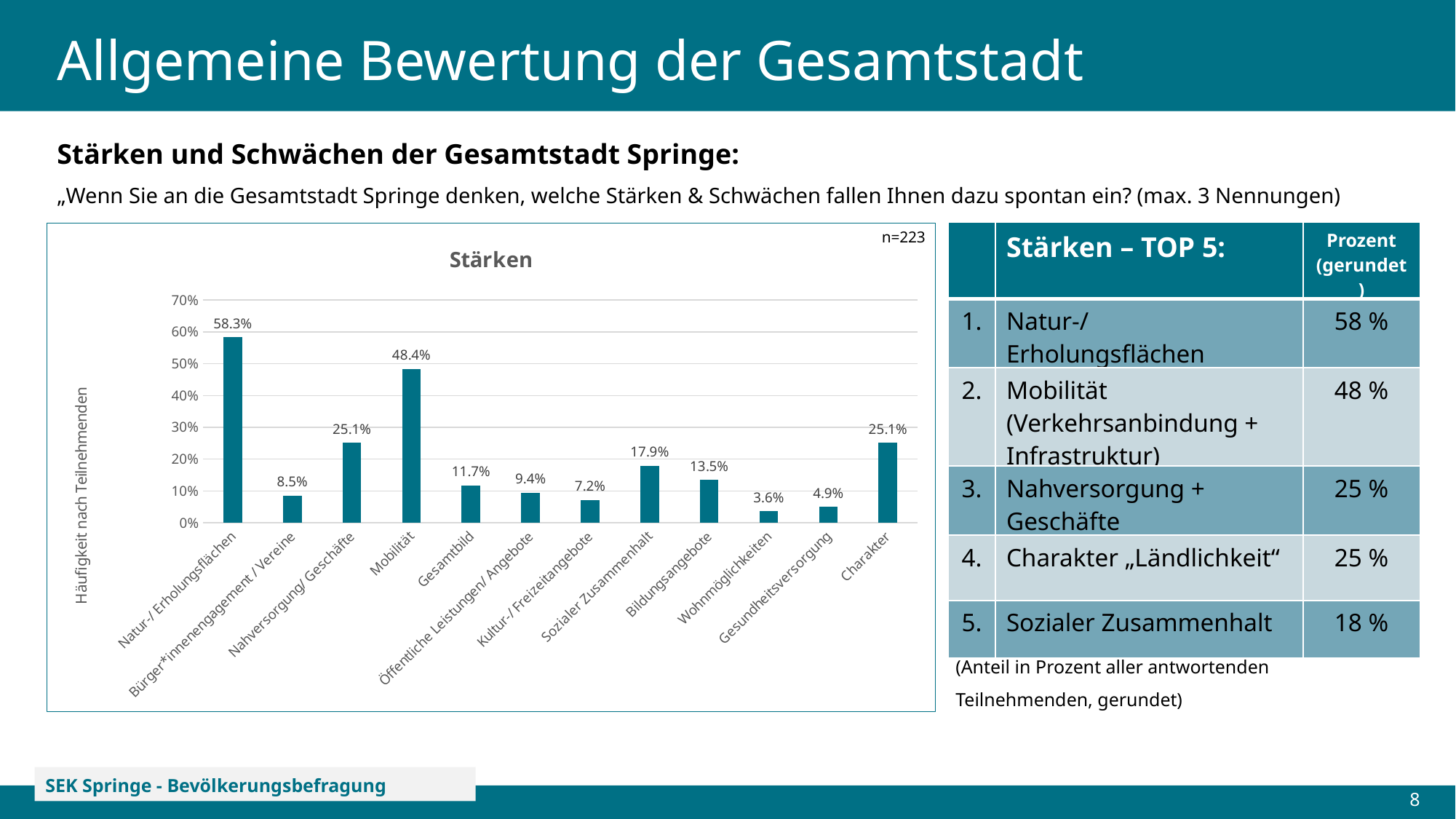
What is the sample size (n) shown on the Stärken chart? n=223 How many categories are shown in the Stärken chart? 12 What kind of chart is the Stärken chart? bar chart Which is larger in the Stärken chart: Bildungsangebote or Gesamtbild? Bildungsangebote Is the value for Sozialer Zusammenhalt in the Stärken chart greater or less than 20%? less What is the value for Natur-/ Erholungsflächen in the Stärken chart? 58.3% What is the value for Sozialer Zusammenhalt in the Stärken chart? 17.9% What is the value for Wohnmöglichkeiten in the Stärken chart? 3.6% Which category has the lowest value in the Stärken chart? Wohnmöglichkeiten What is the difference between the values for Natur-/ Erholungsflächen and Mobilität in the Stärken chart? 9.9% Which category has the highest value in the Stärken chart? Natur-/ Erholungsflächen What is the value for Mobilität in the Stärken chart? 48.4%